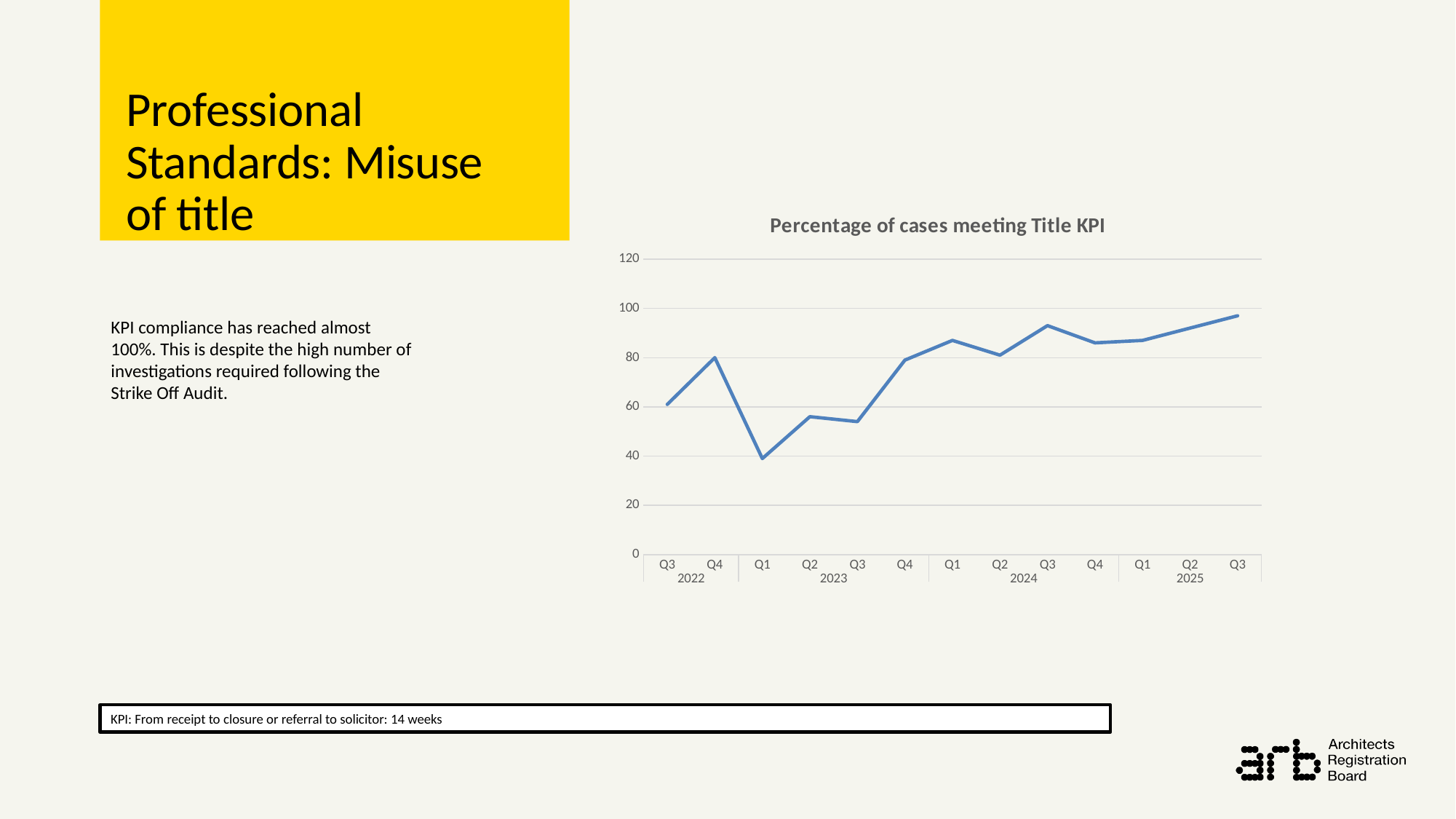
Does the percentage of cases meeting the Title KPI generally rise or fall from Q1 2023 to Q3 2025? rise Is the value for Q2 2023 greater or less than 60? less Is the value for Q3 2025 greater or less than 100? less Which quarter has the highest percentage of cases meeting the Title KPI? Q3 2025 What is the title of the chart? Percentage of cases meeting Title KPI How many quarterly data points are plotted on the chart? 13 Which quarter has the lowest percentage of cases meeting the Title KPI? Q1 2023 What kind of chart is shown on the slide? line chart Which is larger, the value for Q4 2022 or the value for Q1 2023? Q4 2022 Is the value for Q3 2024 greater or less than 80? greater